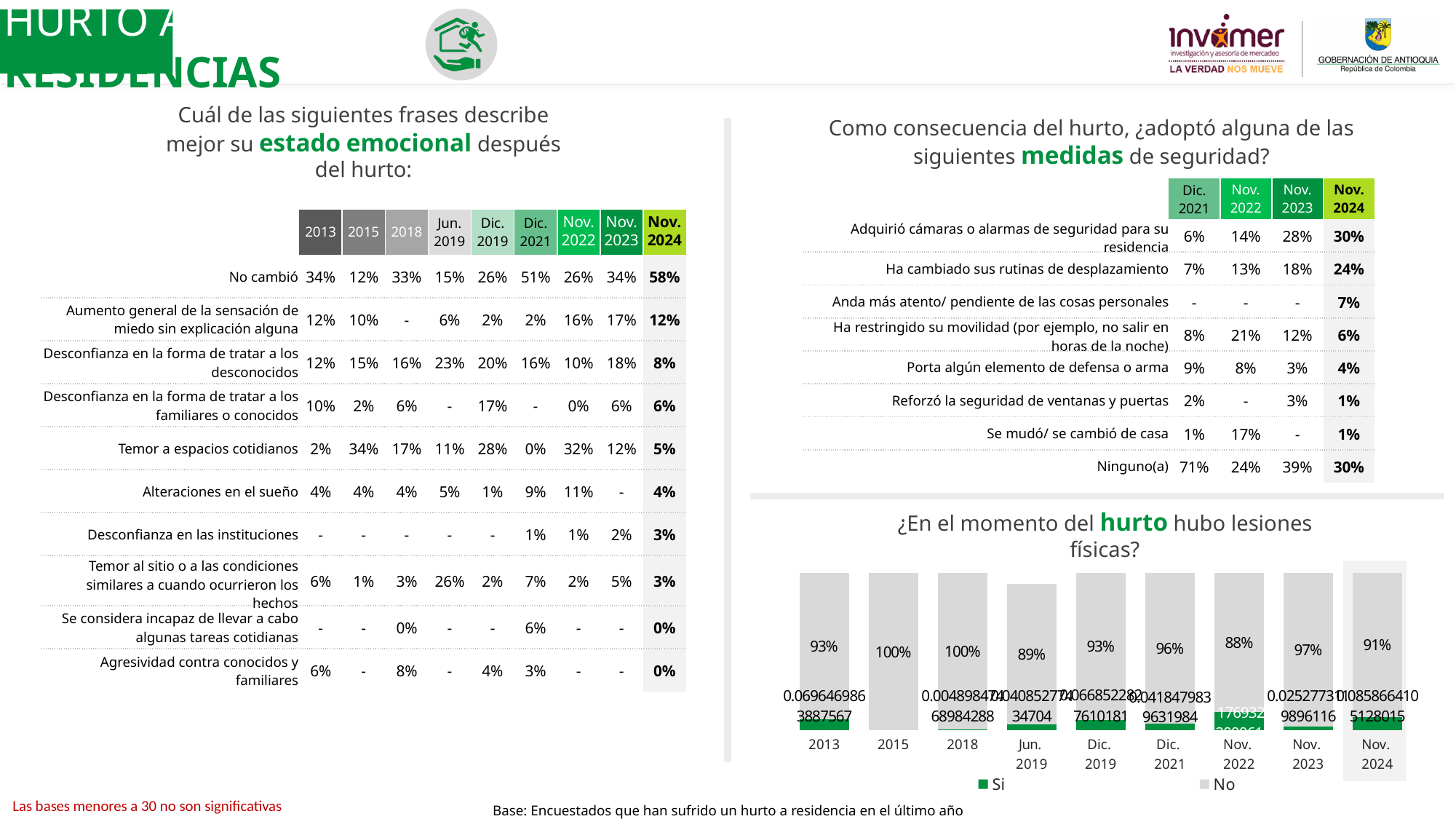
In the chart '¿En el momento del hurto hubo lesiones físicas?', what is the 'No' value for Nov. 2022? 88% In the chart '¿En el momento del hurto hubo lesiones físicas?', how many series does the legend list? 2 In the table 'estado emocional después del hurto', what is the Nov. 2024 value for 'No cambió'? 58% In the chart '¿En el momento del hurto hubo lesiones físicas?', what is the 'No' value for Nov. 2024? 91% In the chart '¿En el momento del hurto hubo lesiones físicas?', what are the two legend entries? Si and No In the chart '¿En el momento del hurto hubo lesiones físicas?', how many time periods are shown along the x axis? 9 In the chart '¿En el momento del hurto hubo lesiones físicas?', which period has the lowest 'No' value? Nov. 2022 In the chart '¿En el momento del hurto hubo lesiones físicas?', what is the difference between the 'No' values for Nov. 2023 and Nov. 2022? 9 percentage points What kind of chart is used for '¿En el momento del hurto hubo lesiones físicas?'? Stacked bar chart In the chart '¿En el momento del hurto hubo lesiones físicas?', which periods show a 'No' value of 100%? 2015 and 2018 In the chart '¿En el momento del hurto hubo lesiones físicas?', which has the larger 'No' value: Dic. 2021 or Jun. 2019? Dic. 2021 In the table on 'medidas de seguridad', what is the Nov. 2024 value for 'Ninguno(a)'? 30%